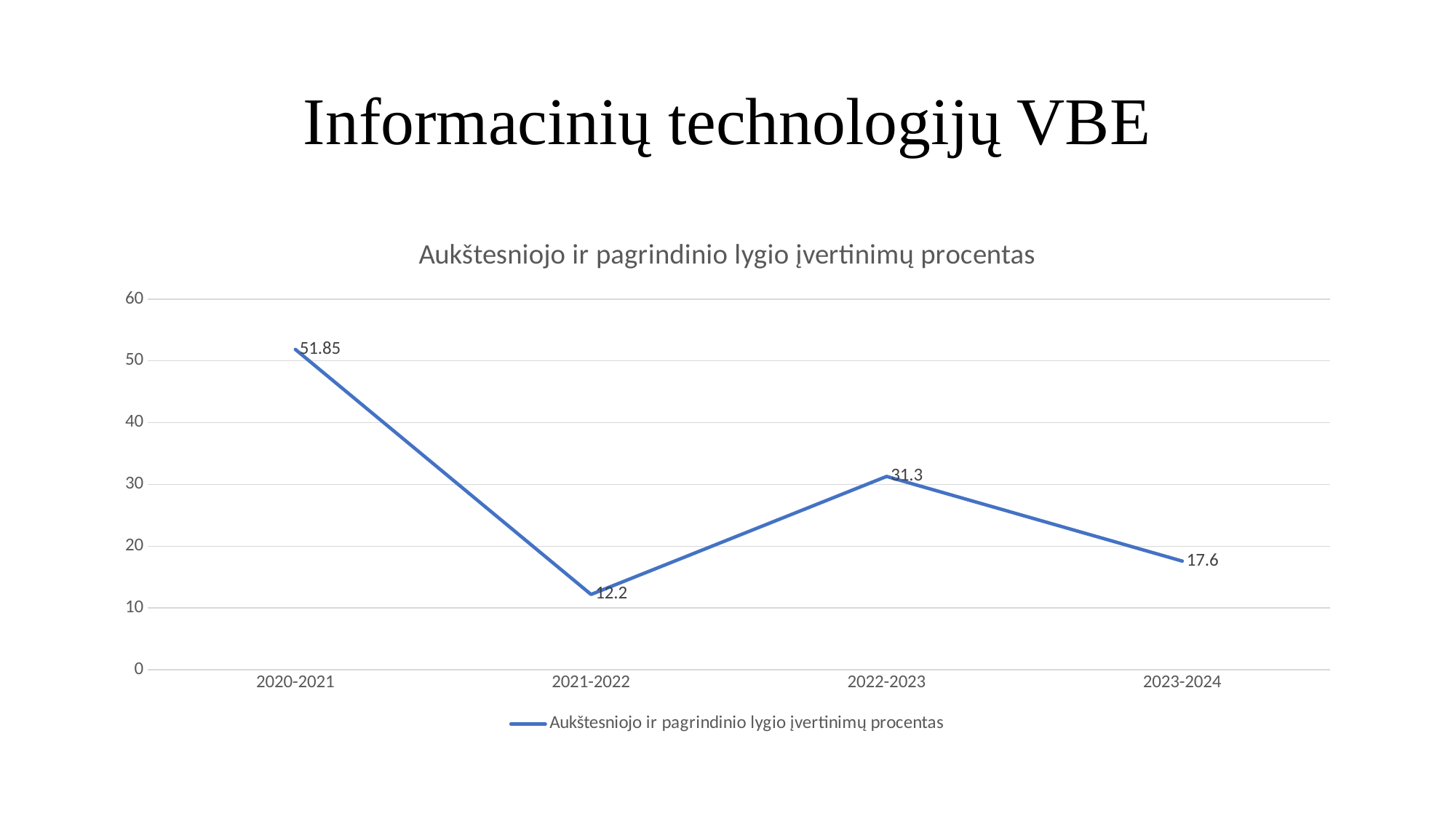
How many periods are plotted on the x axis? 4 What is the difference between the values for 2022-2023 and 2023-2024? 13.7 What is the value for 2021-2022? 12.2 Which is larger, the value for 2022-2023 or the value for 2023-2024? 2022-2023 Which period has the highest value? 2020-2021 What is the title of the chart? Aukštesniojo ir pagrindinio lygio įvertinimų procentas What is the difference between the values for 2020-2021 and 2021-2022? 39.65 What kind of chart is shown on the slide? Line chart What is the value for 2020-2021? 51.85 Which period has the lowest value? 2021-2022 What is the value for 2022-2023? 31.3 What is the value for 2023-2024? 17.6